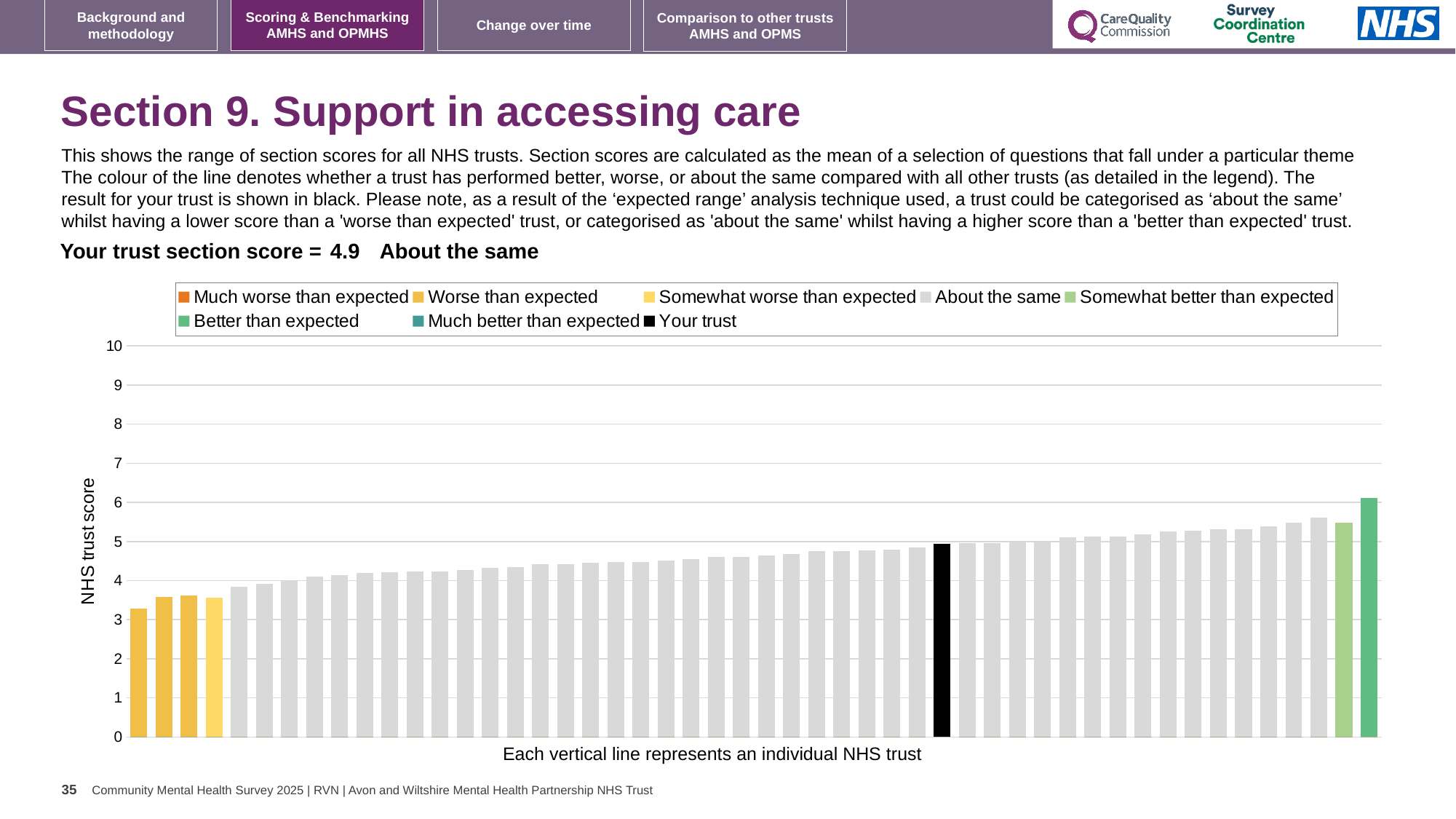
Which legend category does the tallest bar belong to? Better than expected How many bars are coloured yellow at the left of the chart? 4 What kind of chart is shown on the slide? bar chart Do the bar values rise or fall moving from left to right along the x axis? rise What is the section score for your trust shown on the slide? 4.9 Is the value of the leftmost bar greater or less than 4? less Is the value of the tallest bar (rightmost) greater or less than 5? greater Which category is your trust placed in for this section? About the same What is the label on the y axis of the chart? NHS trust score What colour is the bar representing your trust? black Is the value of the black 'Your trust' bar greater or less than 4? greater How many entries does the chart legend list? 8